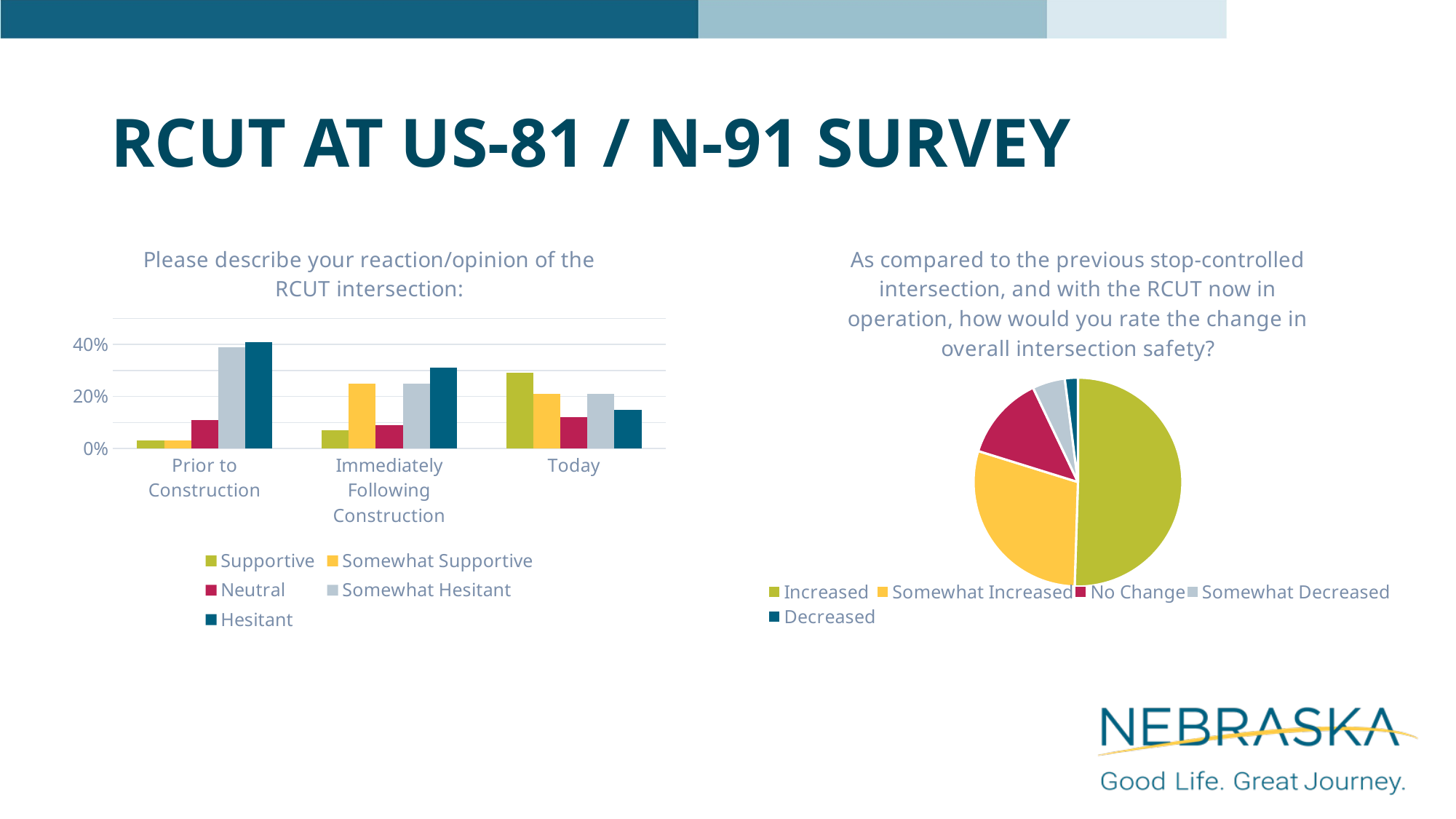
In the left bar chart, which series has the highest value at Today? Supportive In the left bar chart, is the value for Supportive at Today greater or less than 20%? greater What kind of chart is the chart on the right of the slide, about the change in overall intersection safety? pie chart In the left bar chart, which series has the highest value at Prior to Construction? Hesitant What kind of chart is the chart on the left of the slide, titled "Please describe your reaction/opinion of the RCUT intersection:"? bar chart In the left bar chart, how many categories are shown on the x axis? 3 In the right pie chart, how many slices does the legend list? 5 In the right pie chart, which slice is the largest? Increased In the left bar chart, how many series does the legend list? 5 In the left bar chart, is the value for Supportive at Prior to Construction greater or less than 20%? less In the left bar chart, does the Supportive series rise or fall from Prior to Construction to Today? rise